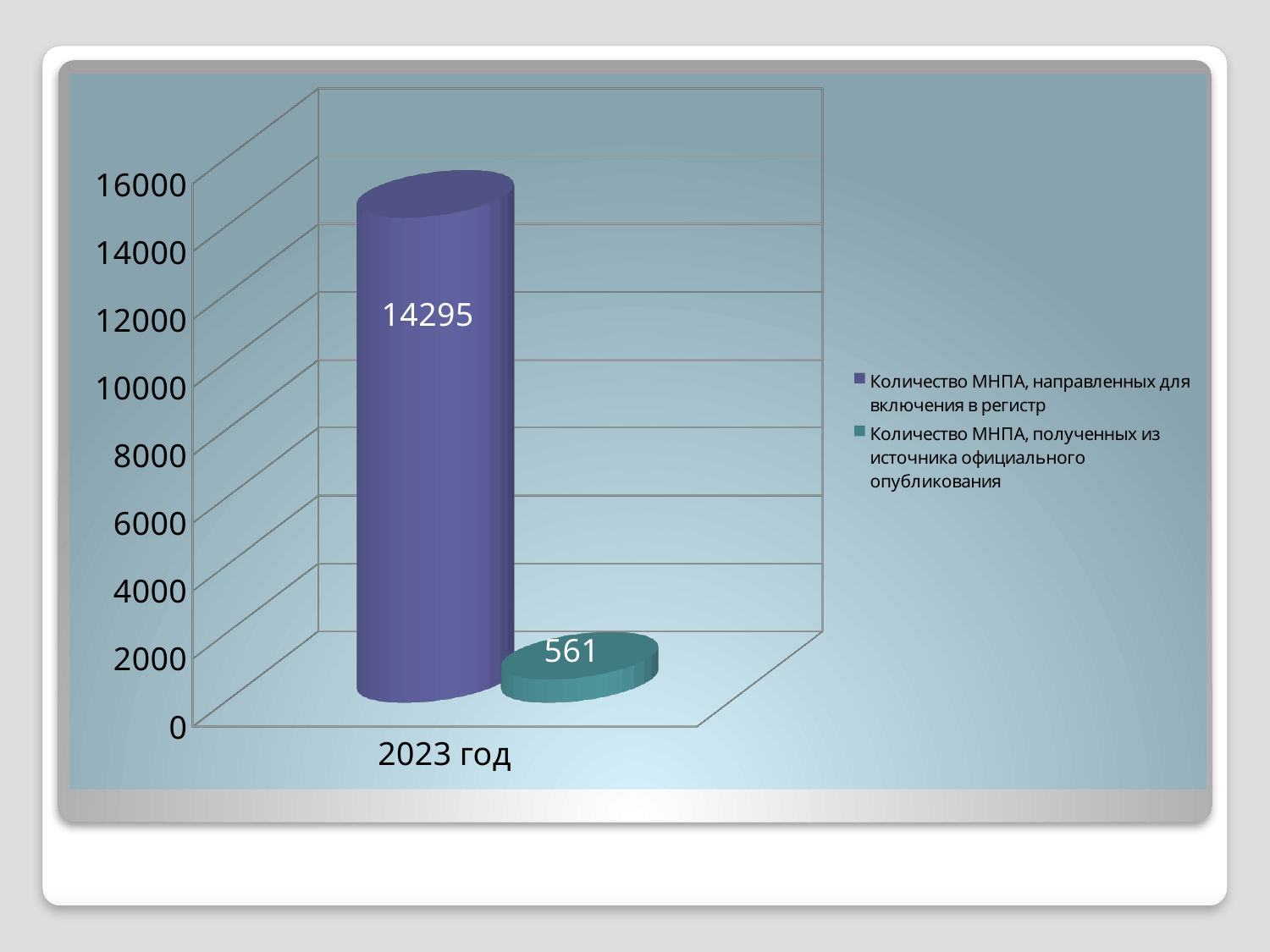
Which series has the higher value in 2023 год? Количество МНПА, направленных для включения в регистр Is the value for 'Количество МНПА, полученных из источника официального опубликования' greater or less than 2000? less Is the value for 'Количество МНПА, направленных для включения в регистр' larger or smaller than the value for 'Количество МНПА, полученных из источника официального опубликования'? larger What kind of chart is shown on the slide? bar chart How many series does the legend list? 2 What is the value for 'Количество МНПА, направленных для включения в регистр' in 2023 год? 14295 Which series has the lower value in 2023 год? Количество МНПА, полученных из источника официального опубликования What is the difference between the two values shown for 2023 год? 13734 What is the category label on the x axis? 2023 год What is the value for 'Количество МНПА, полученных из источника официального опубликования' in 2023 год? 561 How many categories are shown on the x axis? 1 Is the value for 'Количество МНПА, направленных для включения в регистр' greater or less than 10000? greater